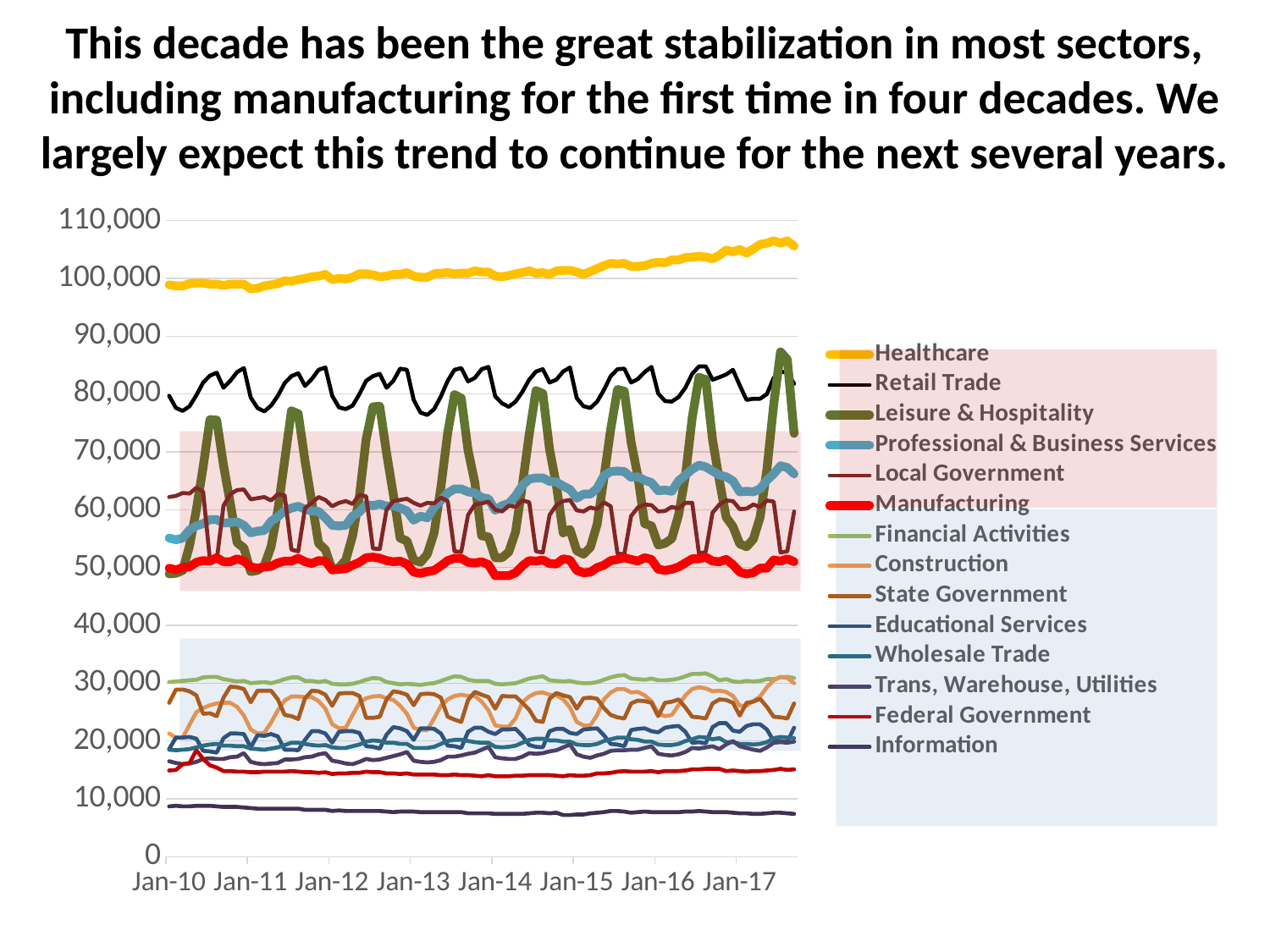
What colour is the Manufacturing line in the legend? red Which series is larger in Jan-12, Healthcare or Retail Trade? Healthcare Is the value for Federal Government in Jan-16 greater or less than 20,000? less Is the value for Retail Trade in Jan-14 greater or less than 70,000? greater How many year labels are shown on the x axis? 8 What kind of chart is shown on the slide? line chart How many series does the legend list? 14 Is the value for Information in Jan-10 greater or less than 10,000? less Which series has the highest values throughout the chart? Healthcare Does the Healthcare series rise or fall from Jan-10 to Jan-17? rise Which series has the lowest values throughout the chart? Information